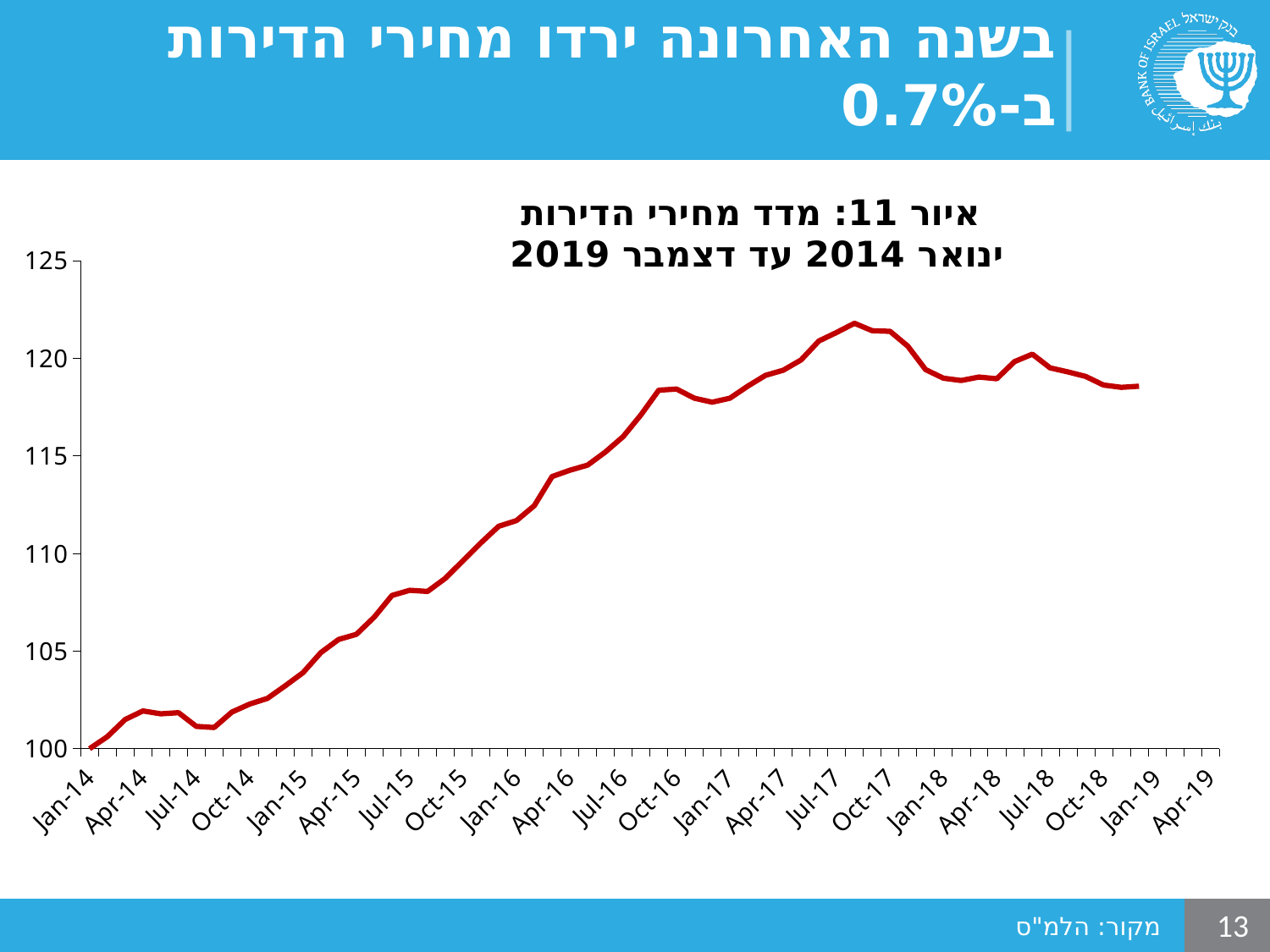
Is the value for Jan-16 greater or less than 110? greater What colour is the line in the chart? red Overall, does the index rise or fall from Jan-14 to Jan-19? rise What is the value of the housing price index at Jan-14? 100 At which x-axis label is the index at its lowest value? Jan-14 Is the value for Jan-17 greater or less than 115? greater What is the title of the chart? איור 11: מדד מחירי הדירות ינואר 2014 עד דצמבר 2019 Is the highest point of the line greater or less than 120? greater What kind of chart is shown on the slide? line chart Which is larger, the value at Jan-15 or the value at Jan-17? Jan-17